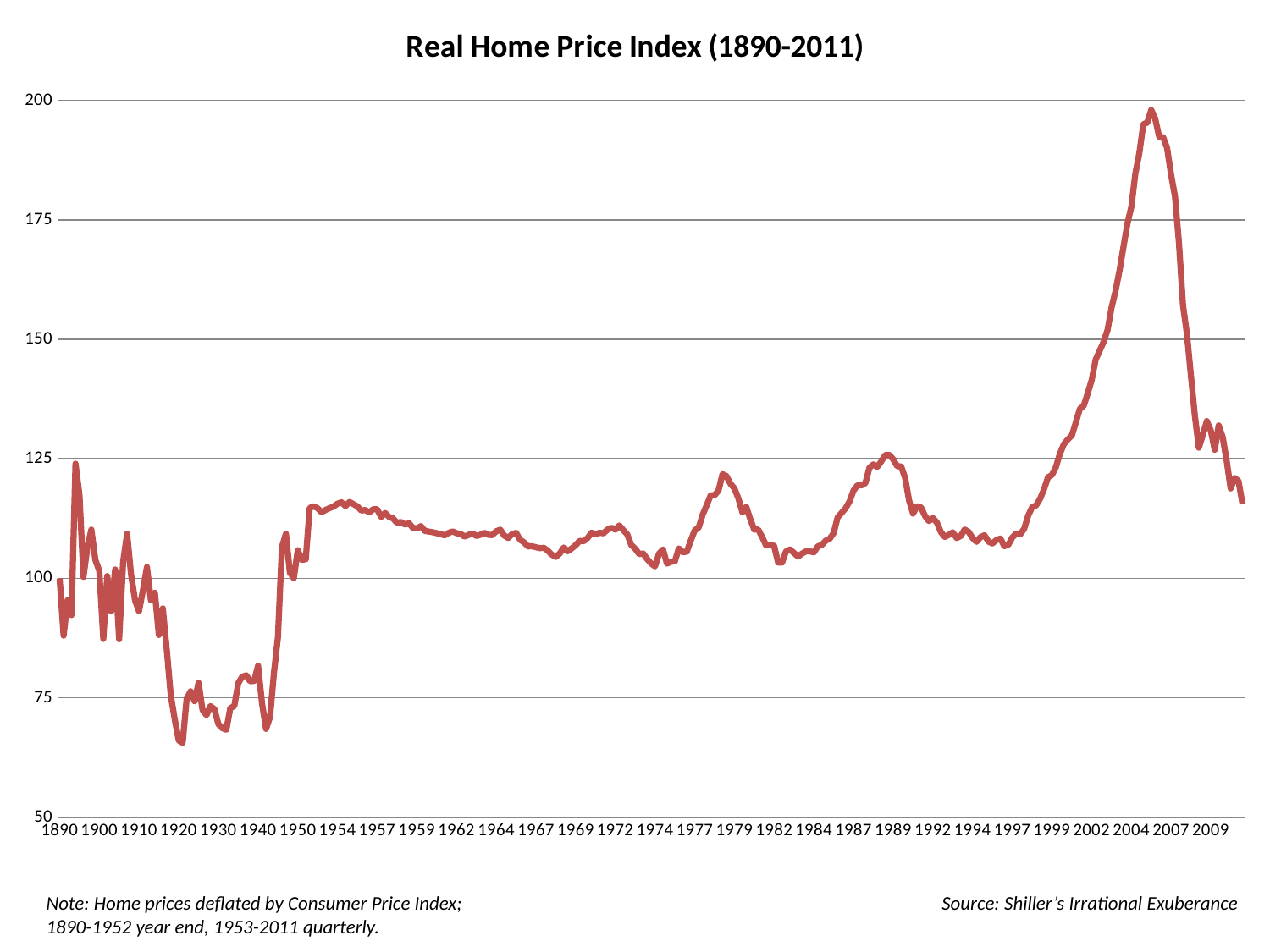
Is the peak value of the index around 2006 greater or less than 175? greater Does the index rise or fall between 1997 and 2006? rise What source is cited for the chart? Shiller's Irrational Exuberance Is the value of the index in 1890 greater or less than 125? less What is the title of the chart? Real Home Price Index (1890-2011) Is the value of the index around 1920 greater or less than 75? less Which is higher: the peak of the index around 2006 or the peak around 1989? the peak around 2006 How many lines are plotted on the chart? 1 What kind of chart is shown on the slide? line chart Does the index rise or fall between 2006 and 2009? fall